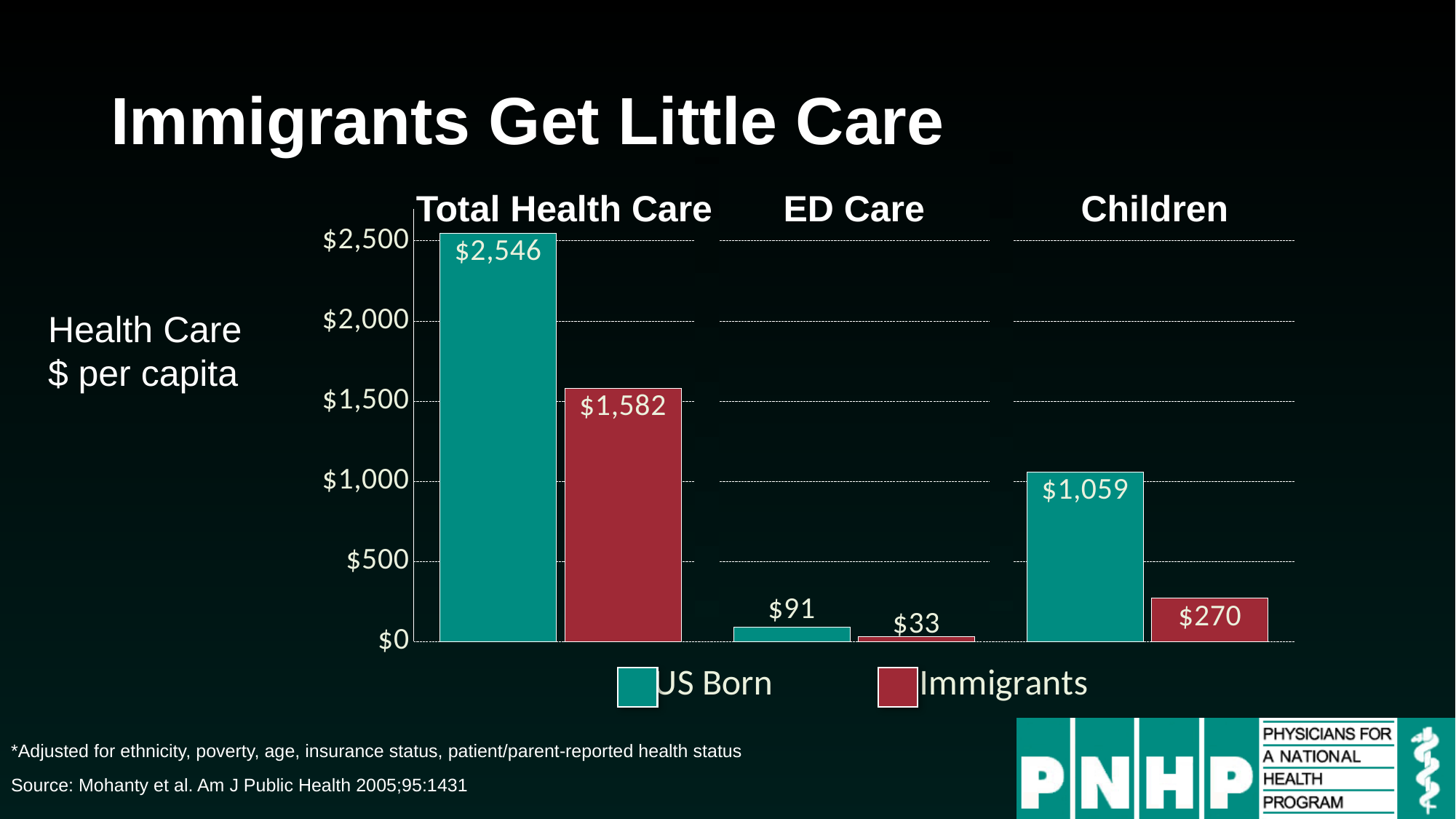
What is the difference between the US Born and Immigrants values for Total Health Care? $964 Which category has the lowest value for Immigrants? ED Care What kind of chart is shown on the slide? Bar chart What is the difference between the US Born and Immigrants values for Children? $789 Which category has the highest value for US Born? Total Health Care What is the y-axis label of the chart? Health Care $ per capita Which is larger for ED Care, the US Born value or the Immigrants value? US Born What is the Total Health Care value for Immigrants? $1,582 How many series does the legend list? 2 What is the ED Care value for Immigrants? $33 What is the Total Health Care value for US Born? $2,546 What is the Children value for US Born? $1,059